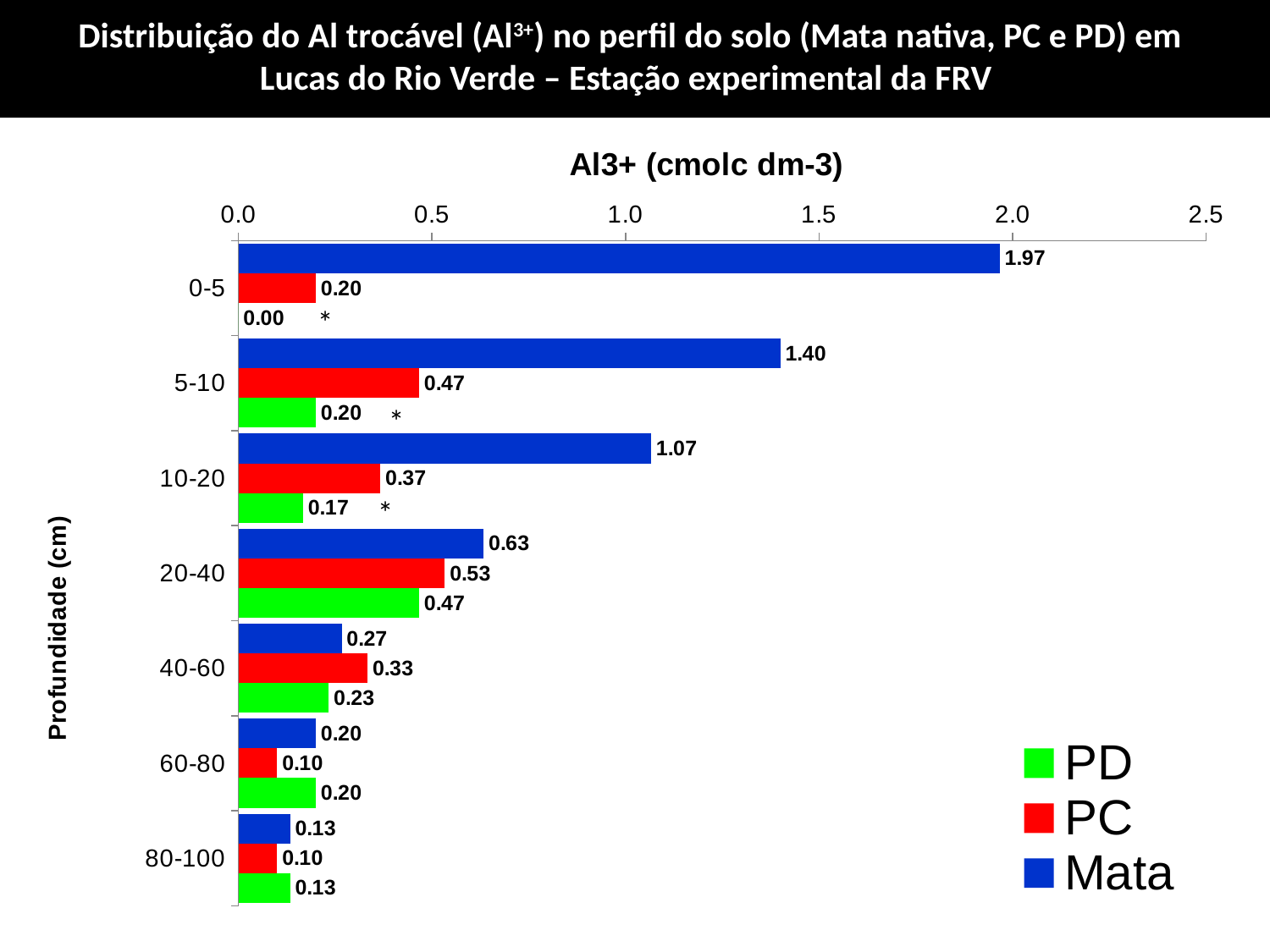
What is the difference between the Mata and PC values at the 10-20 cm depth? 0.70 What is the PD value at the 20-40 cm depth? 0.47 At which depth is the Mata value highest? 0-5 What is the PC value at the 5-10 cm depth? 0.47 How many depth categories are shown on the chart? 7 What is the Mata value at the 0-5 cm depth? 1.97 At the 40-60 cm depth, which is larger, the PC value or the Mata value? PC Is the Mata value at the 5-10 cm depth greater or less than 1.0? greater At which depth is the PD value lowest? 0-5 How many series does the legend list? 3 Which colour represents the Mata series in the legend? blue What kind of chart is shown on the slide? bar chart